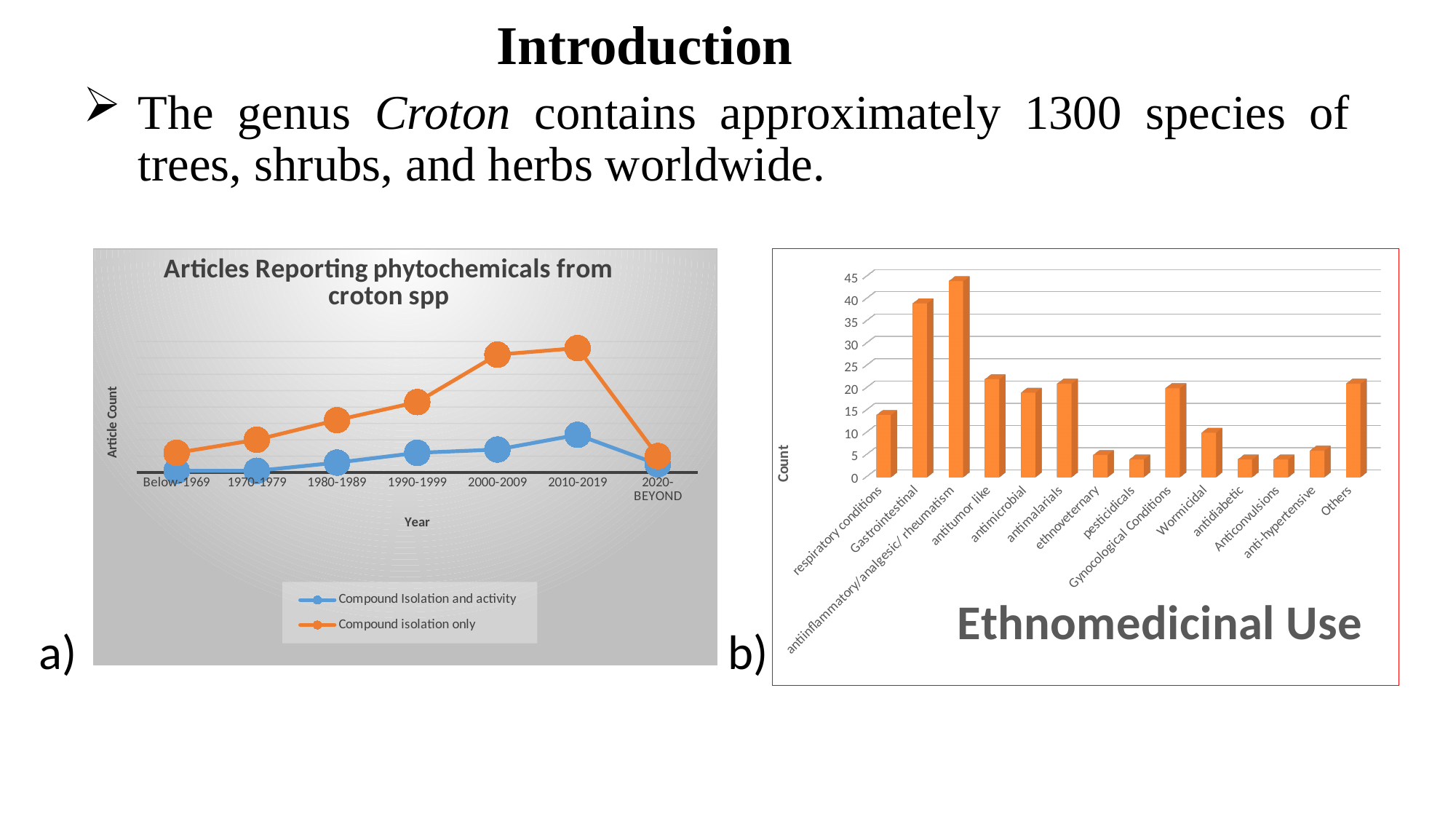
In chart b), which category has the highest count? antiinflammatory/analgesic/ rheumatism In chart a), which year category has the highest value for 'Compound isolation only'? 2010-2019 In chart a), which year category has the highest value for 'Compound Isolation and activity'? 2010-2019 How many series does the legend of chart a) list? 2 What kind of chart is chart a), 'Articles Reporting phytochemicals from croton spp'? line chart In chart a), does the 'Compound isolation only' series rise or fall from Below-1969 to 2010-2019? rise In chart a), which series is plotted in orange? Compound isolation only In chart b), which has the larger count, Gastrointestinal or antitumor like? Gastrointestinal In chart b), is the count for Gastrointestinal greater or less than 35? greater How many categories are shown in chart b), 'Ethnomedicinal Use'? 14 How many year categories are shown on the x axis of chart a)? 7 What kind of chart is chart b), 'Ethnomedicinal Use'? bar chart